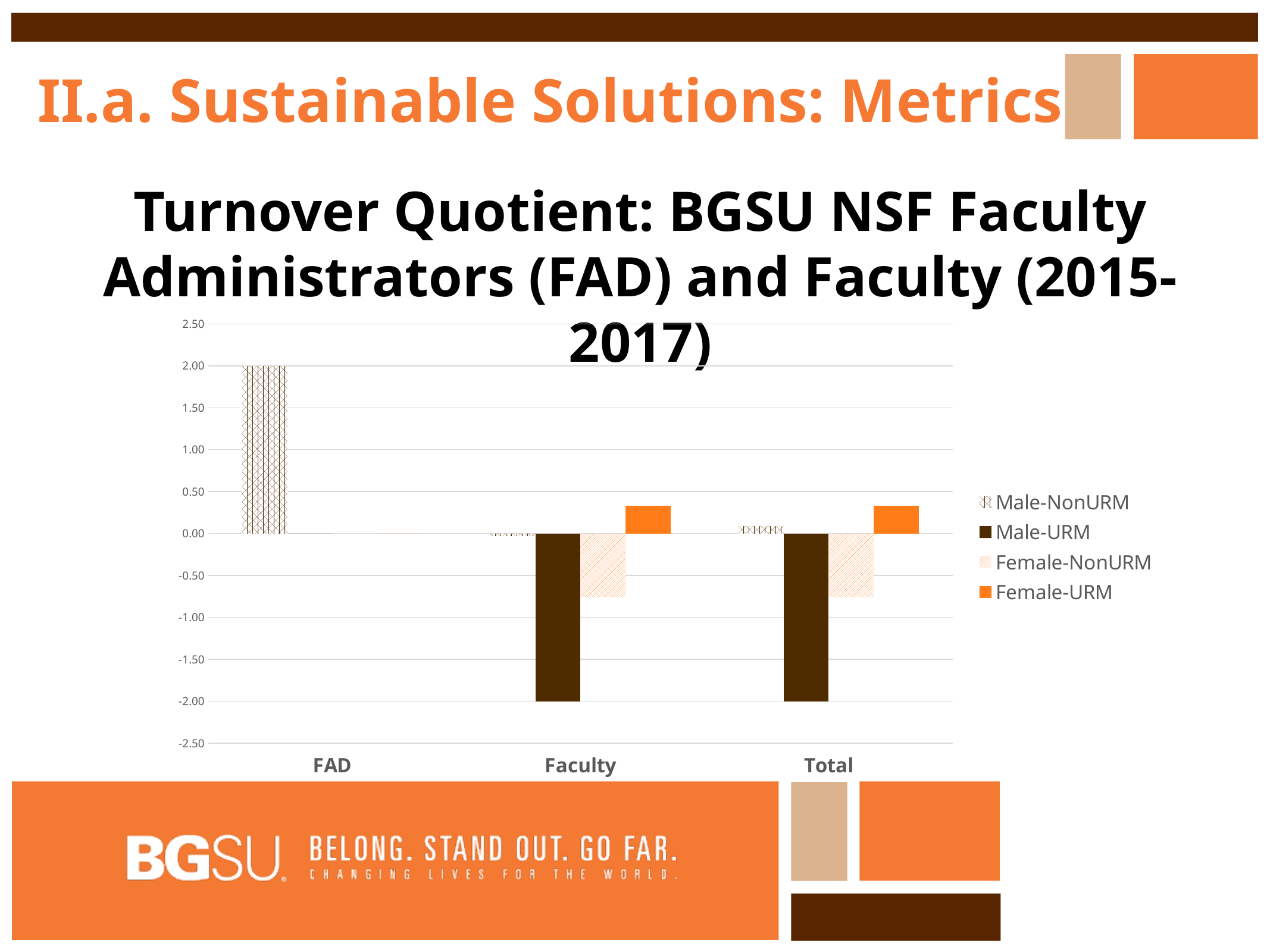
What is the value for Male-URM in the Faculty category? -2.00 Which series is shown in solid orange in the legend? Female-URM How many categories are shown on the x axis of the chart? 3 What kind of chart is shown on the slide? Bar chart Which series has the highest value in the FAD category? Male-NonURM What is the value for Male-NonURM in the FAD category? 2.00 Is the value for Female-NonURM in the Faculty category greater or less than -0.50? less What is the value for Male-URM in the Total category? -2.00 Is the value for Female-URM in the Total category greater or less than 0.50? less Which series has the lowest value in the Faculty category? Male-URM Which is larger: the Male-NonURM value for FAD or the Female-URM value for Faculty? Male-NonURM value for FAD How many series does the chart legend list? 4